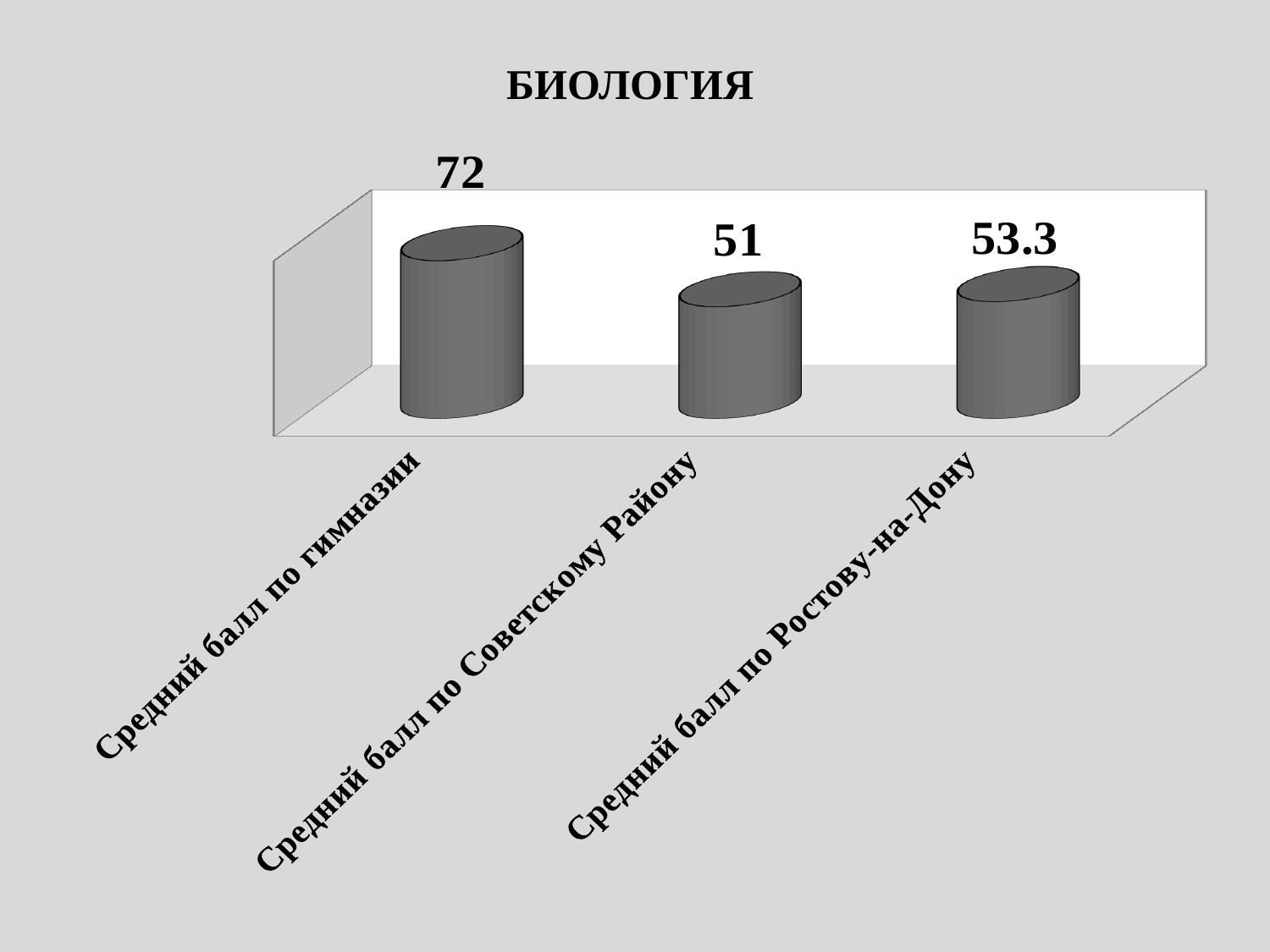
Which is larger: the value for Средний балл по гимназии or the value for Средний балл по Ростову-на-Дону? Средний балл по гимназии What is the difference between the value for Средний балл по гимназии and the value for Средний балл по Советскому Району? 21 What kind of chart is shown on the slide? bar chart What is the difference between the value for Средний балл по Ростову-на-Дону and the value for Средний балл по Советскому Району? 2.3 What is the title of the chart? БИОЛОГИЯ Which category has the highest value? Средний балл по гимназии How many categories are shown in the chart? 3 Which category has the lowest value? Средний балл по Советскому Району What is the value for Средний балл по Ростову-на-Дону? 53.3 What is the value for Средний балл по гимназии? 72 What is the value for Средний балл по Советскому Району? 51